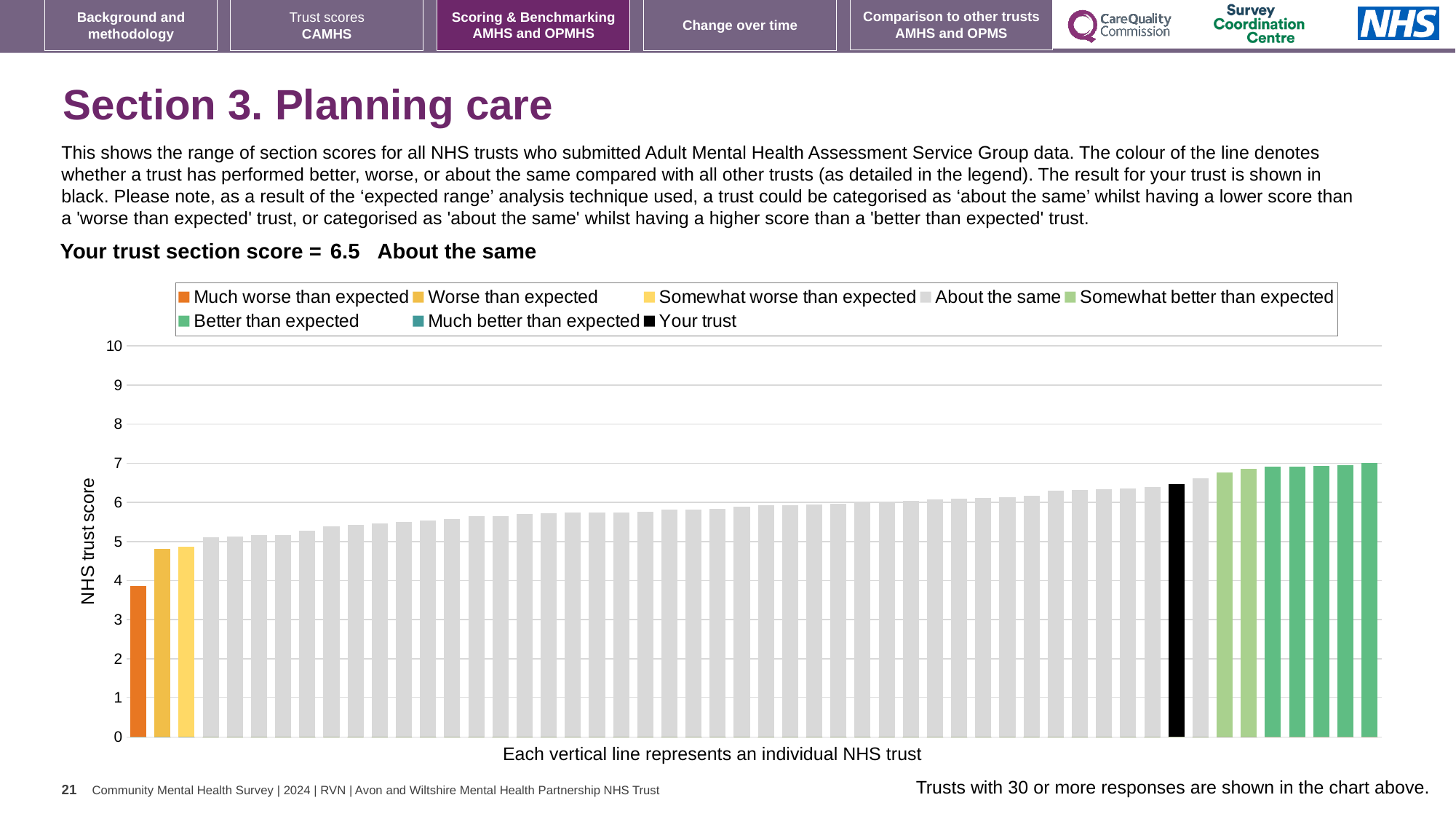
Which category is your trust placed in according to the slide? About the same Is the 'Your trust' bar higher or lower than the 'Much worse than expected' bar? higher How many bars are coloured as 'Better than expected' (dark green)? 5 Is the value of the tallest bar in the chart greater or less than 6? greater How many entries does the chart legend list? 8 What is the label on the vertical axis of the chart? NHS trust score What kind of chart is shown on the slide? bar chart Is the value of the black 'Your trust' bar greater or less than 6? greater Which legend category does the lowest bar in the chart belong to? Much worse than expected Is the value of the 'Much worse than expected' bar greater or less than 4? less Do the bar values rise or fall from left to right along the x axis? rise What is the section score for your trust shown on the slide? 6.5